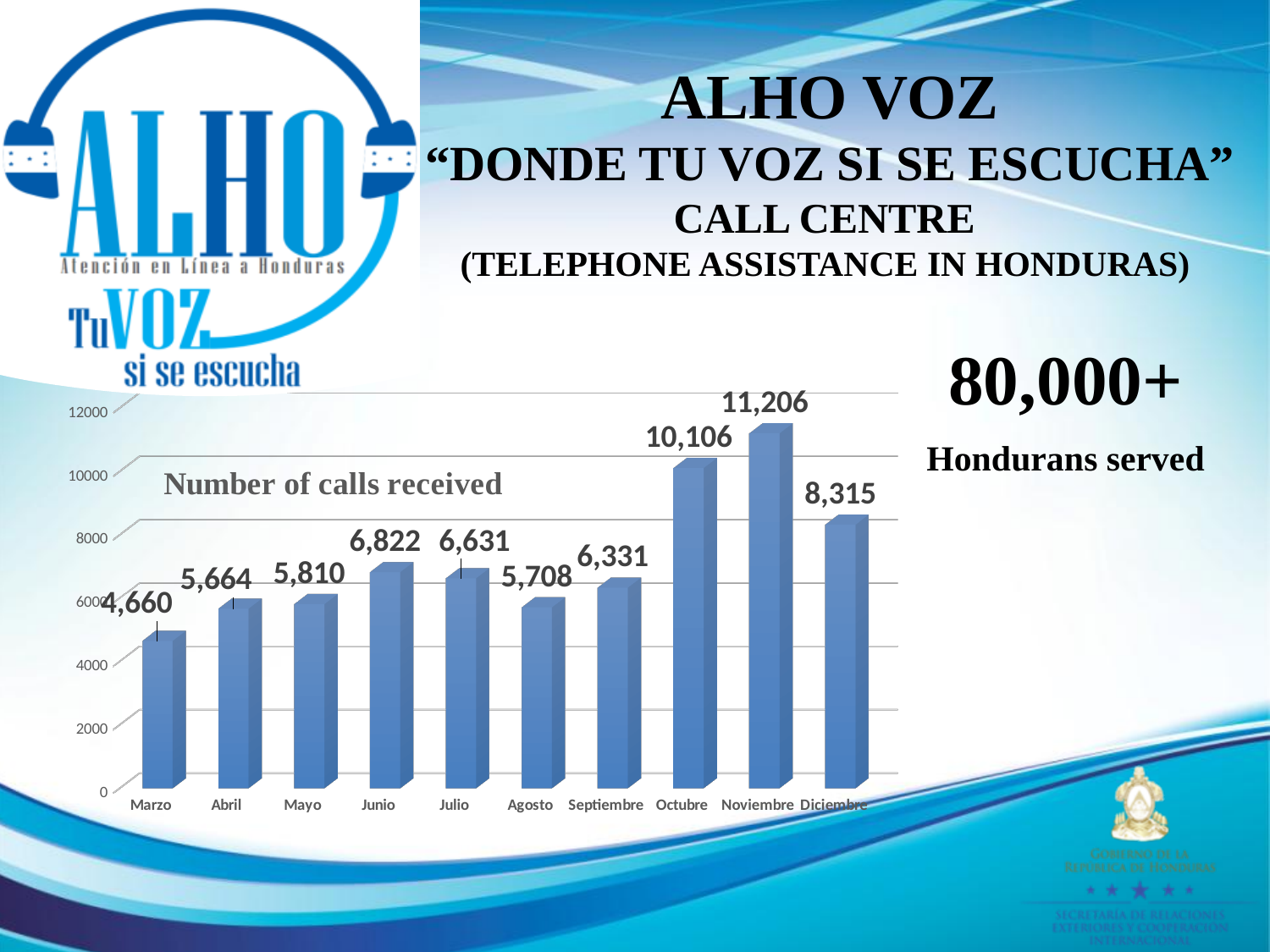
What is the number of calls received in Octubre? 10,106 Which month has the lowest number of calls received? Marzo What is the number of calls received in Marzo? 4,660 What is the difference between the number of calls received in Noviembre and in Octubre? 1,100 How many months are shown on the chart? 10 Which month had more calls received, Junio or Agosto? Junio What is the title of the chart? Number of calls received What is the difference between the number of calls received in Junio and in Marzo? 2,162 Is the value for Diciembre greater or less than 8000? greater What is the number of calls received in Diciembre? 8,315 Which month has the highest number of calls received? Noviembre What kind of chart is used to show the number of calls received? Bar chart